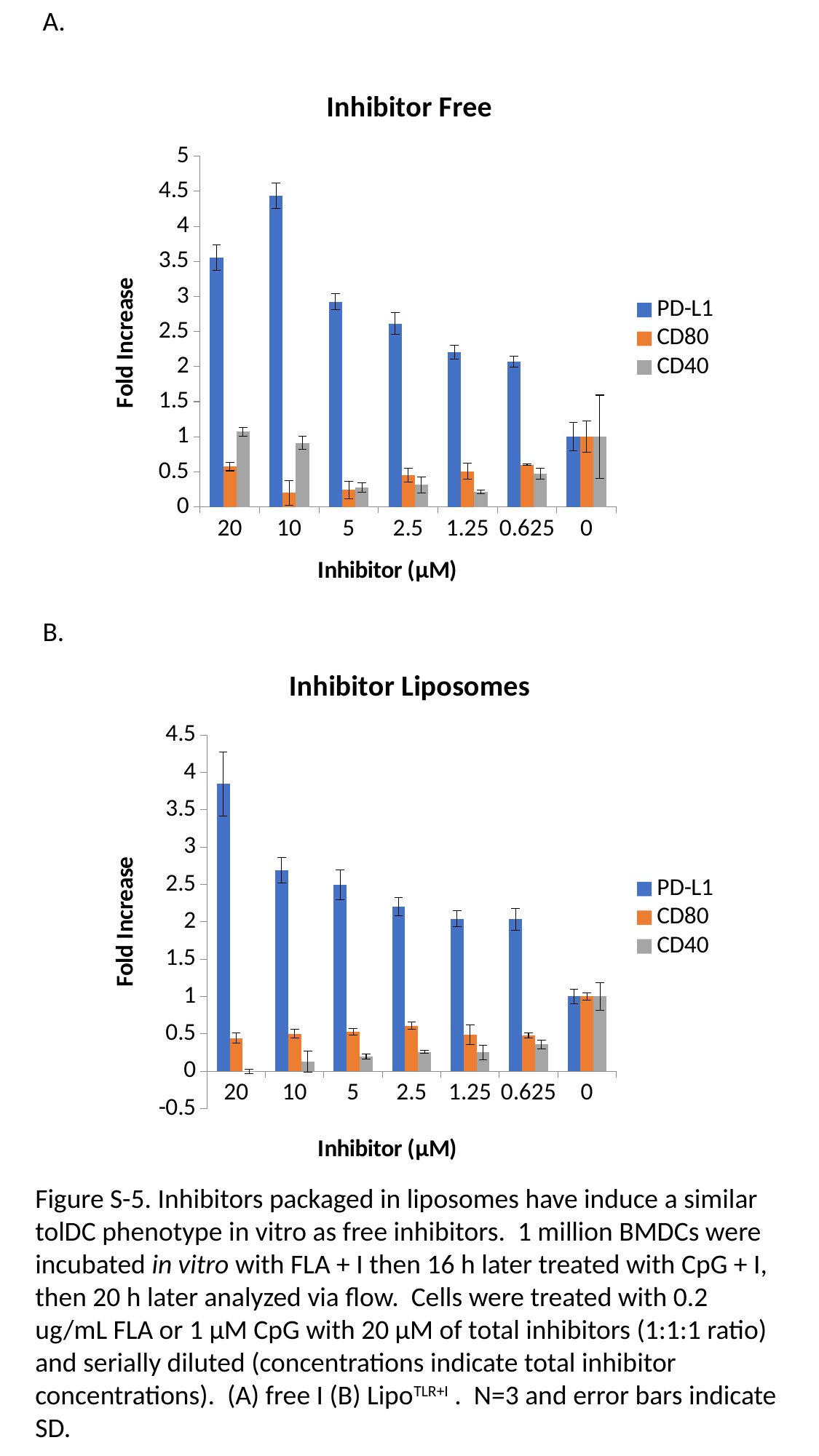
What kind of chart is the 'Inhibitor Free' chart? bar chart How many series does the legend of the 'Inhibitor Liposomes' chart list? 3 In the 'Inhibitor Free' chart, is the PD-L1 value at 10 µM greater or less than 4? greater In the 'Inhibitor Liposomes' chart, at which inhibitor concentration is the PD-L1 bar highest? 20 In the 'Inhibitor Liposomes' chart, is the CD40 value at 10 µM greater or less than 0.5? less What is the y-axis label of the 'Inhibitor Liposomes' chart? Fold Increase In the 'Inhibitor Free' chart, at which inhibitor concentration is the PD-L1 bar highest? 10 In the 'Inhibitor Free' chart, at which inhibitor concentration is the PD-L1 bar lowest? 0 In the 'Inhibitor Liposomes' chart, is the PD-L1 value at 20 µM greater or less than 3.5? greater In the 'Inhibitor Free' chart, which is larger: the PD-L1 value at 20 µM or at 10 µM? 10 µM In the 'Inhibitor Liposomes' chart, does the PD-L1 value rise or fall as the inhibitor concentration goes from 20 to 0 along the x axis? fall How many inhibitor concentration categories are shown on the x axis of the 'Inhibitor Free' chart? 7